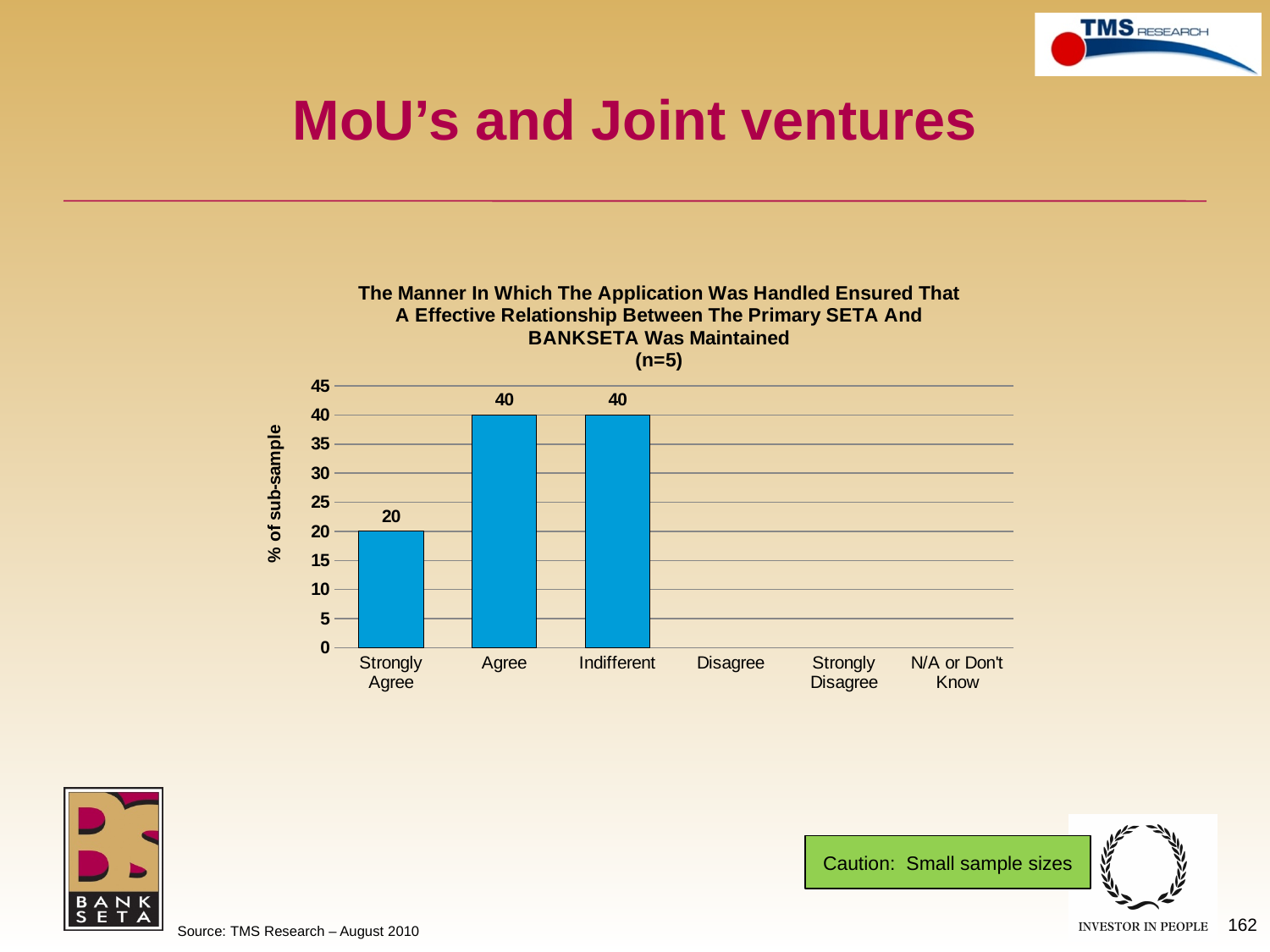
Which is larger, the value for Indifferent or the value for Strongly Agree? Indifferent What is the sample size (n) stated in the chart title? 5 What kind of chart is shown on the slide? bar chart What is the value for Agree? 40 What is the value for Strongly Agree? 20 What is the value for Indifferent? 40 Which category has the lowest non-zero value? Strongly Agree What is the label of the y axis? % of sub-sample What is the difference between the values for Agree and Strongly Agree? 20 What is the total of the values for Strongly Agree, Agree and Indifferent? 100 Is the value for Agree greater or less than 30? greater How many categories are shown on the x axis? 6